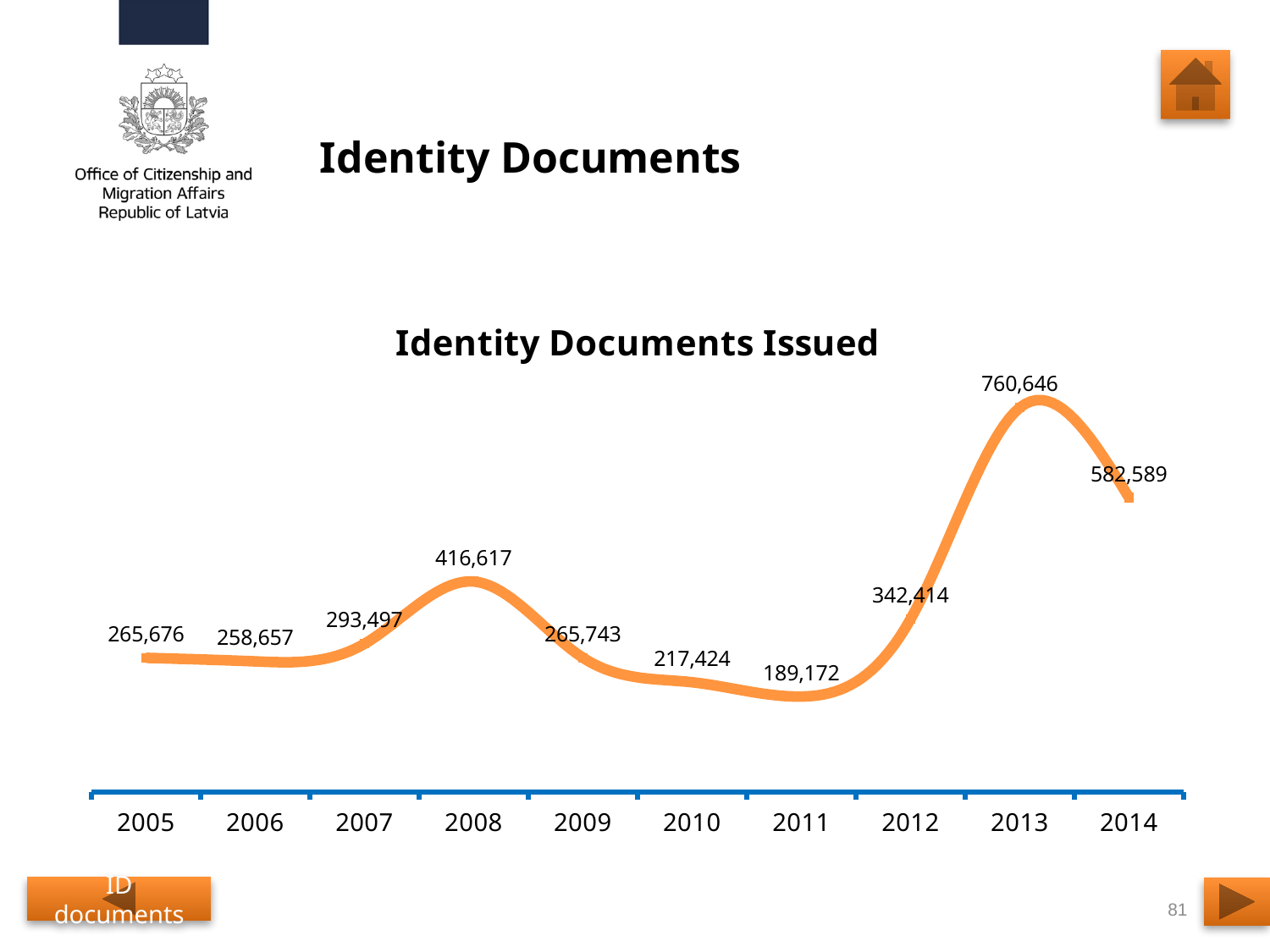
What is the difference between the 2013 and 2014 values? 178,057 What value is shown for 2013 in the Identity Documents Issued chart? 760,646 What type of chart is used to show Identity Documents Issued? Line chart Which year has the lowest value in the chart? 2011 How many identity documents were issued in 2008 according to the chart? 416,617 Which year has the highest value in the Identity Documents Issued chart? 2013 By how much does the 2008 value exceed the 2007 value? 123,120 Which is larger, the value for 2012 or the value for 2010? 2012 What is the value for 2011 in the chart? 189,172 What is the title of the chart on the slide? Identity Documents Issued Do the values rise or fall from 2008 to 2011? Fall How many years are plotted on the x axis of the chart? 10